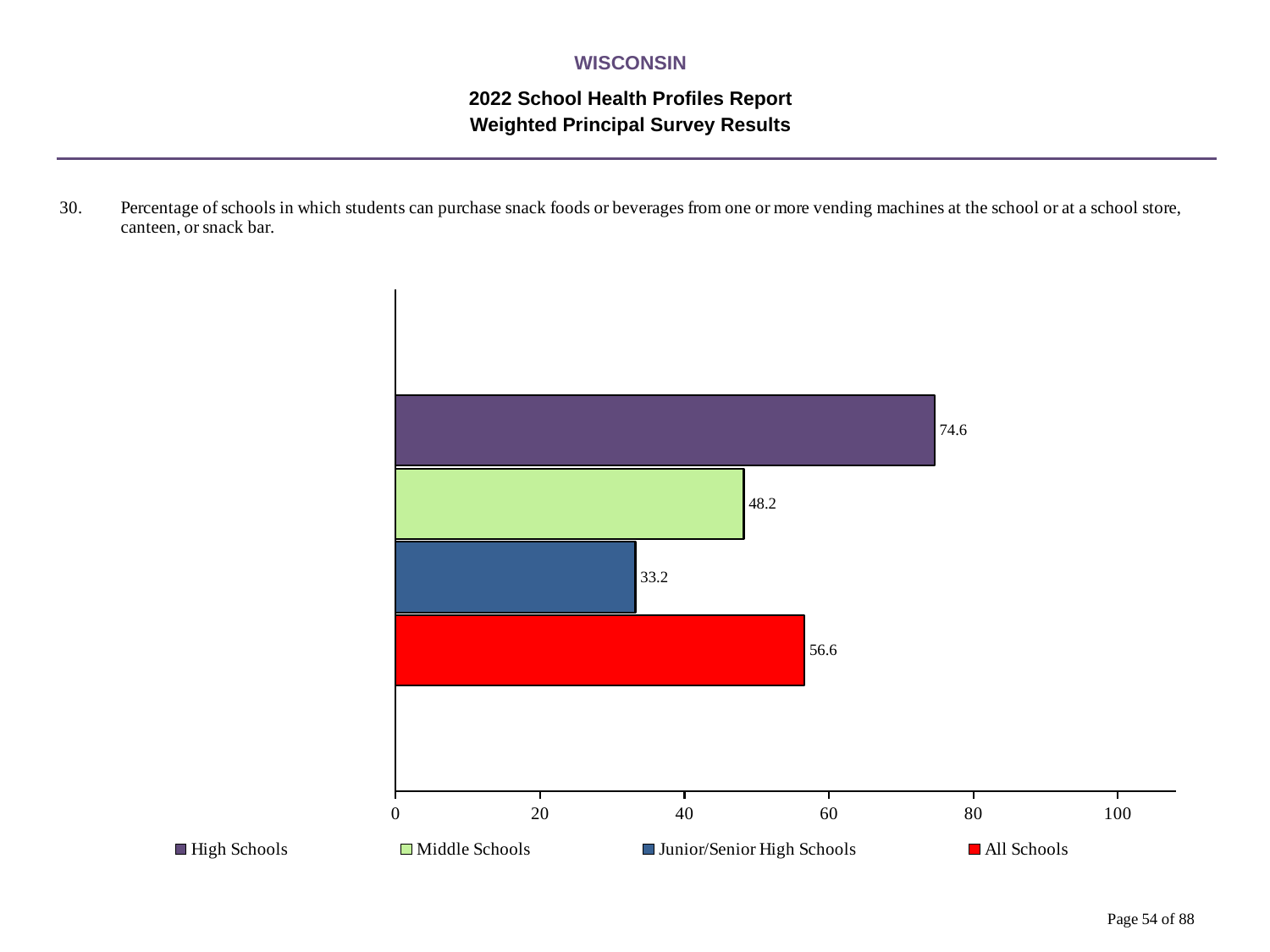
What is the difference between the values for High Schools and Middle Schools? 26.4 What is the value for High Schools? 74.6 Which school type has the highest value? High Schools What is the value for Junior/Senior High Schools? 33.2 How many entries does the legend list? 4 What kind of chart is shown on the slide? bar chart What is the value for Middle Schools? 48.2 What is the value for All Schools? 56.6 Which school type has the lowest value? Junior/Senior High Schools Which is larger, the value for Middle Schools or the value for All Schools? All Schools How many bars are shown in the chart? 4 Is the value for Junior/Senior High Schools greater or less than 40? less